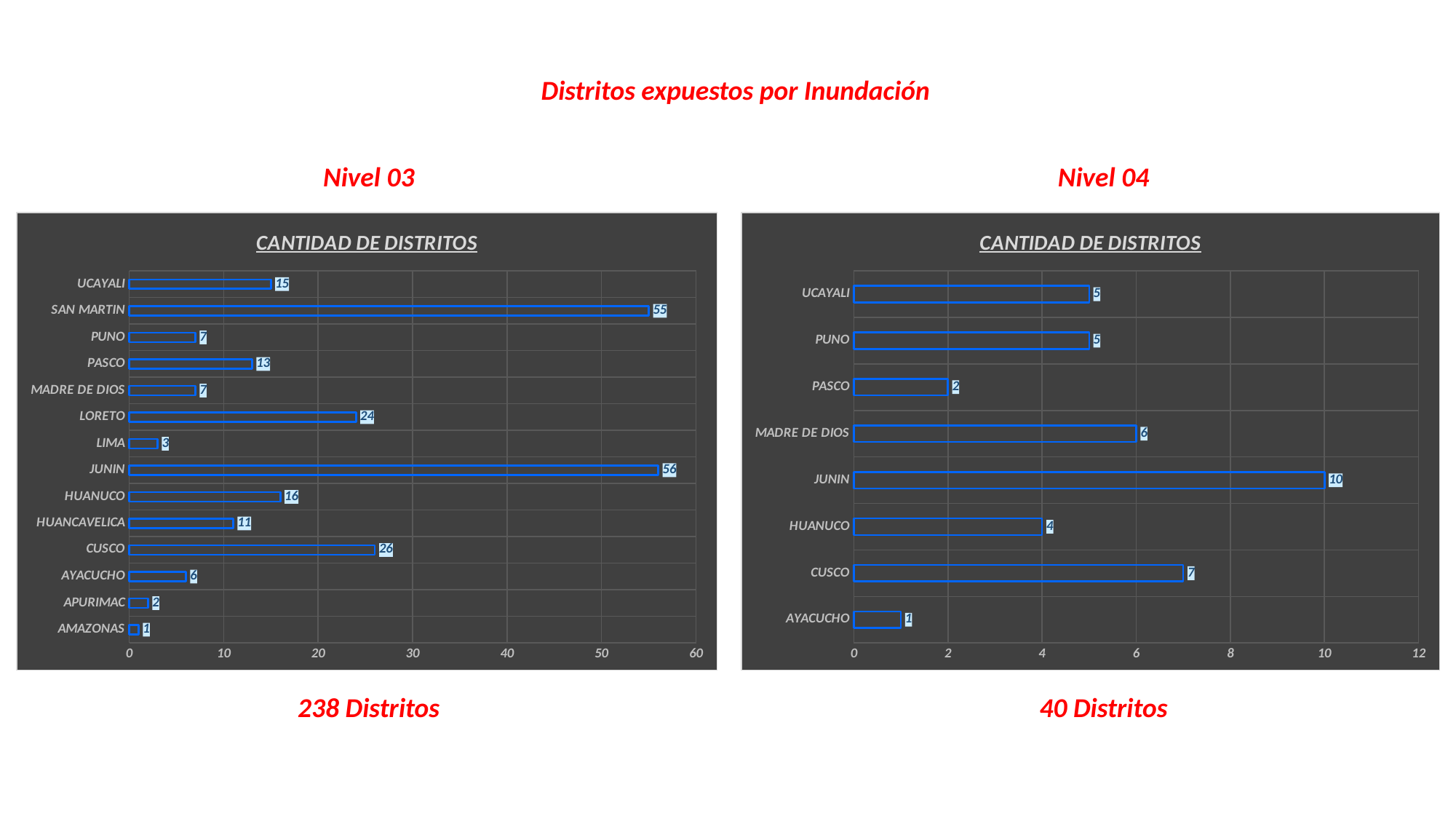
In the Nivel 04 chart, which category has the lowest value? AYACUCHO In the Nivel 04 chart, which category has the highest value? JUNIN In the Nivel 03 chart, what is the difference between the values for CUSCO and LORETO? 2 In the Nivel 04 chart, what is the value for MADRE DE DIOS? 6 In the Nivel 04 chart, what is the difference between the values for JUNIN and CUSCO? 3 In the Nivel 03 chart, what is the value for SAN MARTIN? 55 In the Nivel 04 chart, how many categories are shown? 8 What kind of chart is the Nivel 04 chart? Bar chart In the Nivel 03 chart, which is larger, the value for HUANUCO or the value for UCAYALI? HUANUCO In the Nivel 03 chart, which category has the highest value? JUNIN In the Nivel 03 chart, how many categories are shown? 14 In the Nivel 03 chart, which category has the lowest value? AMAZONAS